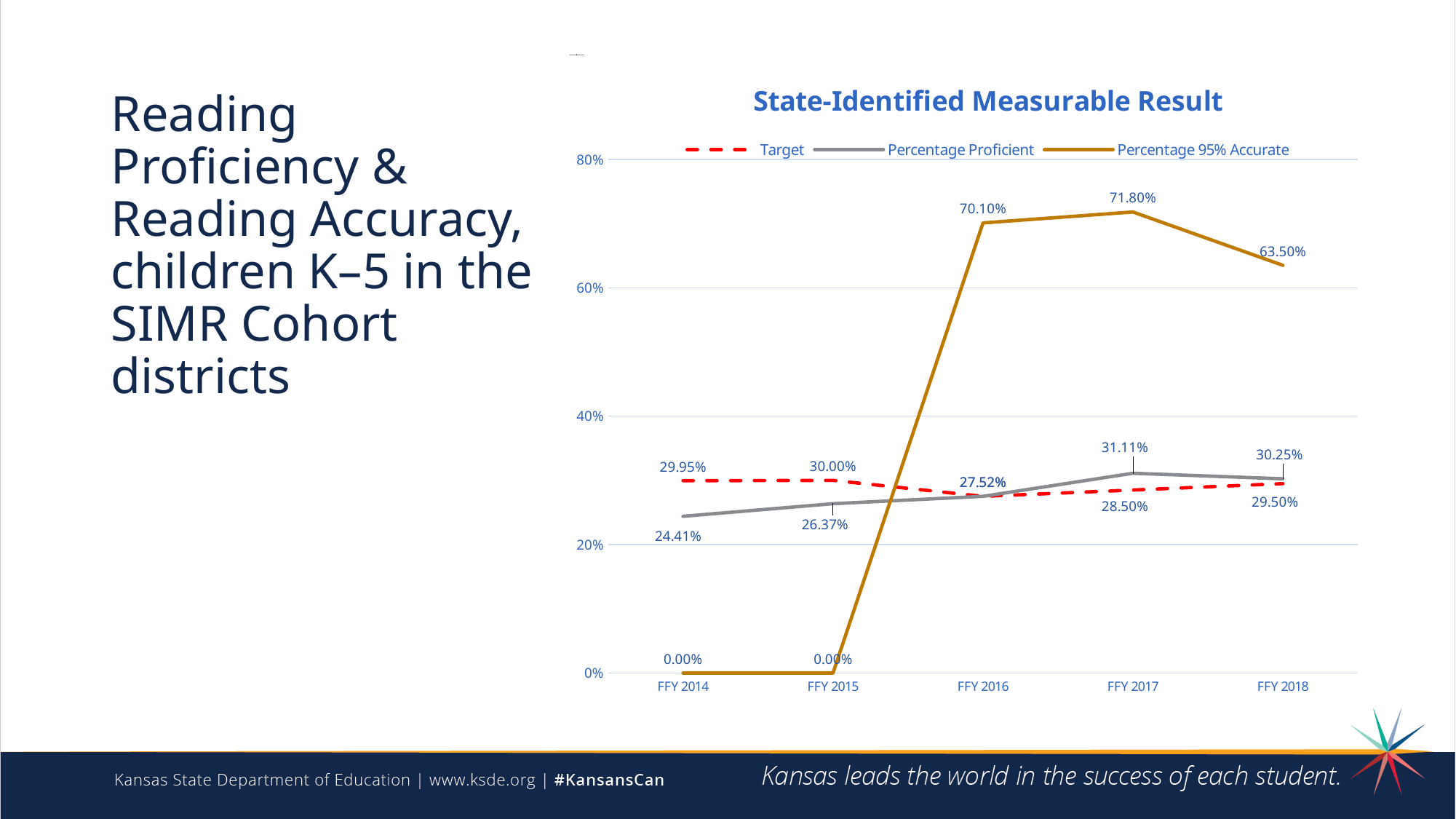
How many years are shown on the x axis? 5 In which year is the Percentage Proficient value lowest? FFY 2014 What is the Percentage 95% Accurate value for FFY 2017? 71.80% What is the Target value for FFY 2015? 30.00% In which year is the Percentage 95% Accurate value highest? FFY 2017 How many series does the legend list? 3 Does the Percentage Proficient value rise or fall from FFY 2014 to FFY 2017? rise By how many percentage points did Percentage 95% Accurate fall from FFY 2017 to FFY 2018? 8.30 percentage points In FFY 2017, which is larger: Percentage Proficient or Target? Percentage Proficient What is the Percentage Proficient value for FFY 2014? 24.41% Is the Percentage 95% Accurate value for FFY 2016 greater or less than 60%? greater What kind of chart is shown on the slide? line chart